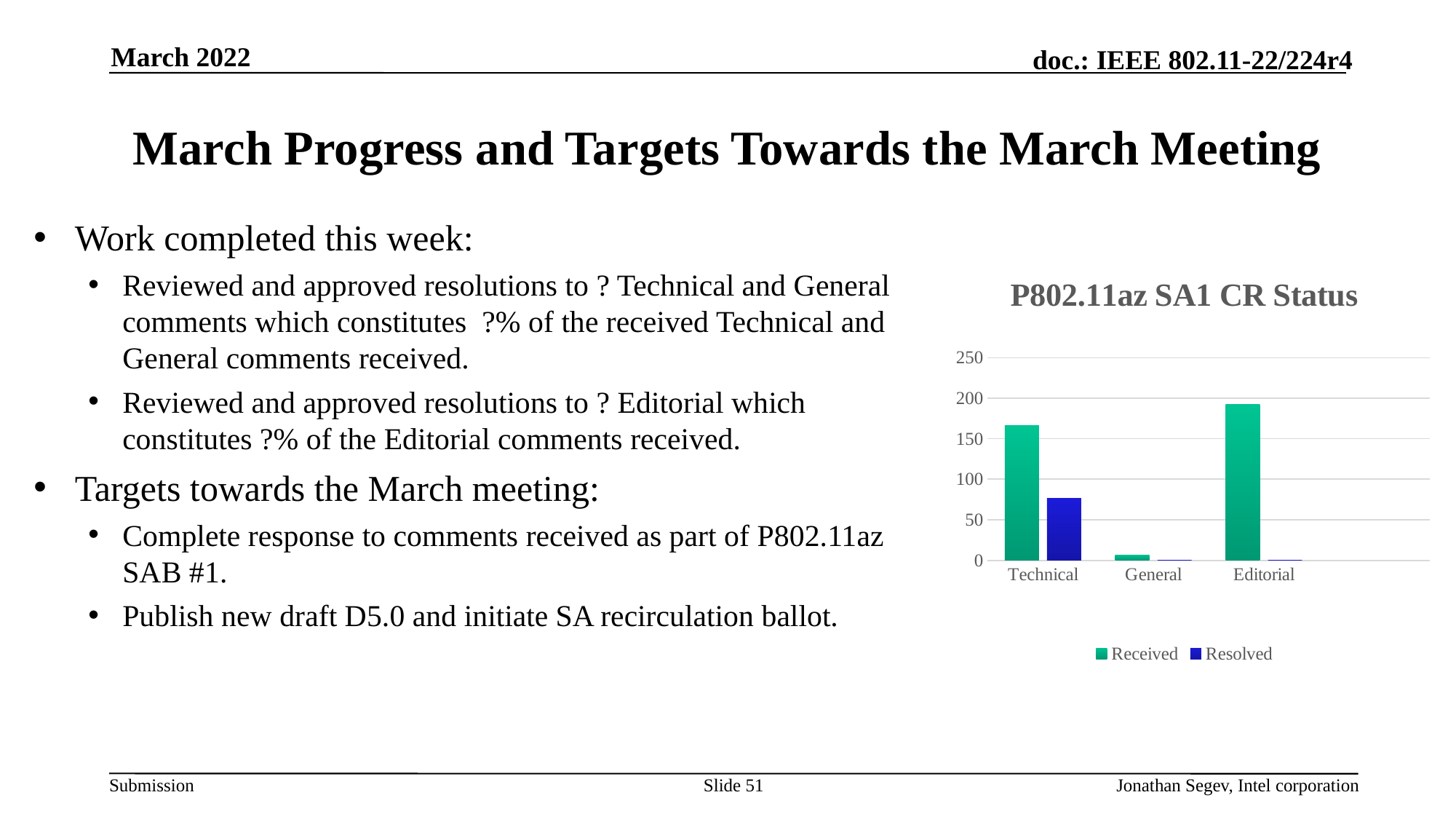
Which is larger: the Received value for Technical or the Received value for Editorial? Editorial Which category has the lowest Received value? General Which series is shown in blue in the chart's legend? Resolved Is the Resolved value for Technical greater or less than 100? less Is the Received value for Technical greater or less than 150? greater What is the title of the chart? P802.11az SA1 CR Status How many categories are shown on the x axis of the chart? 3 Which category has the highest Resolved value? Technical Which category has the highest Received value? Editorial Is the Received value for General greater or less than 50? less What kind of chart is shown on the slide? bar chart How many series does the chart's legend list? 2